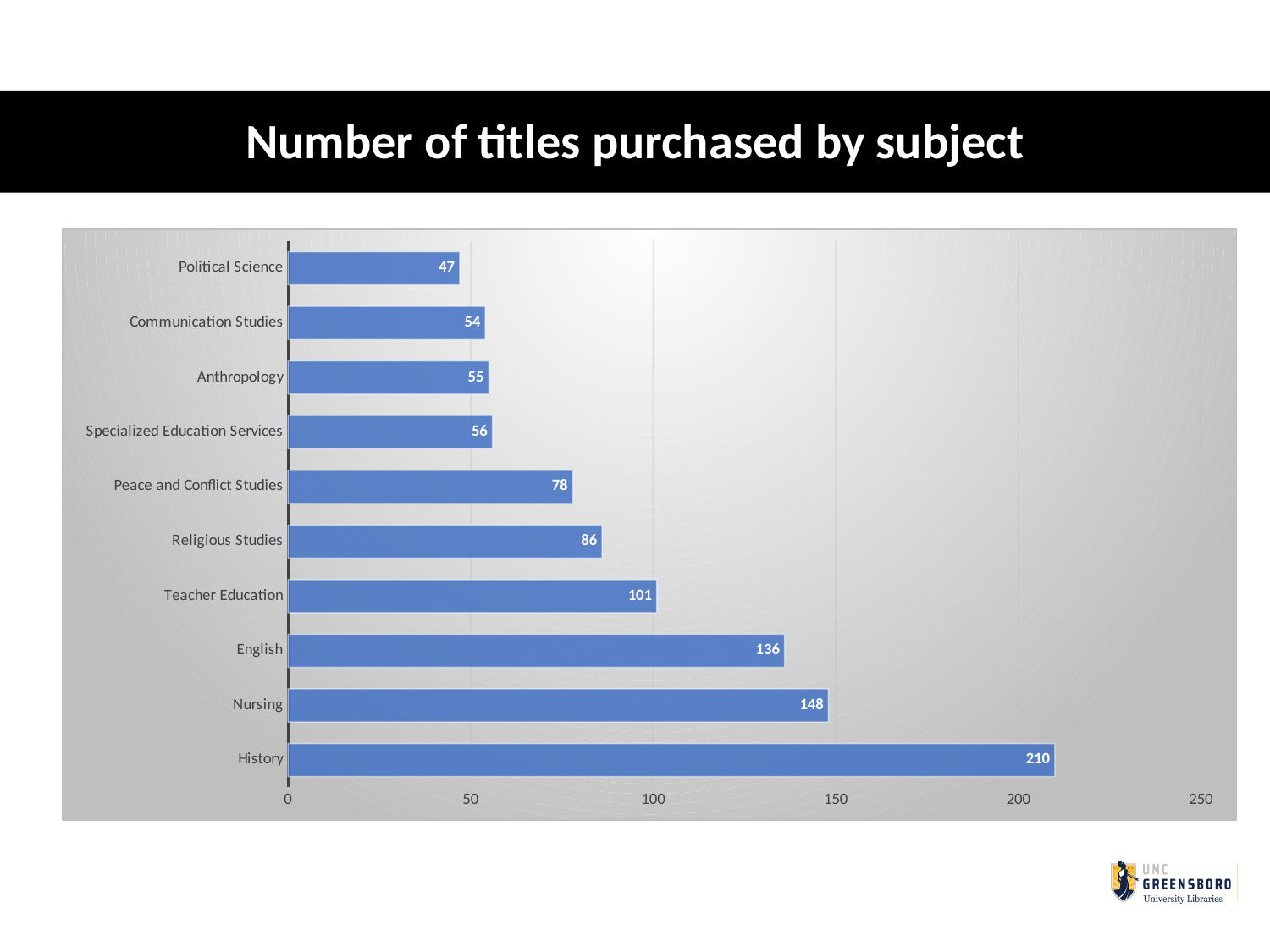
What is the difference between the number of titles purchased for History and for Nursing? 62 What is the difference between the values for English and Teacher Education? 35 What kind of chart is shown on the slide? Bar chart Which subject has the highest number of titles purchased? History Which has more titles purchased, Religious Studies or Communication Studies? Religious Studies Is the value for Teacher Education greater or less than 100? greater What is the value for Peace and Conflict Studies? 78 How many titles were purchased for Nursing? 148 What is the title of the slide? Number of titles purchased by subject How many titles were purchased for History? 210 How many subjects are shown in the chart? 10 Which subject has the lowest number of titles purchased? Political Science